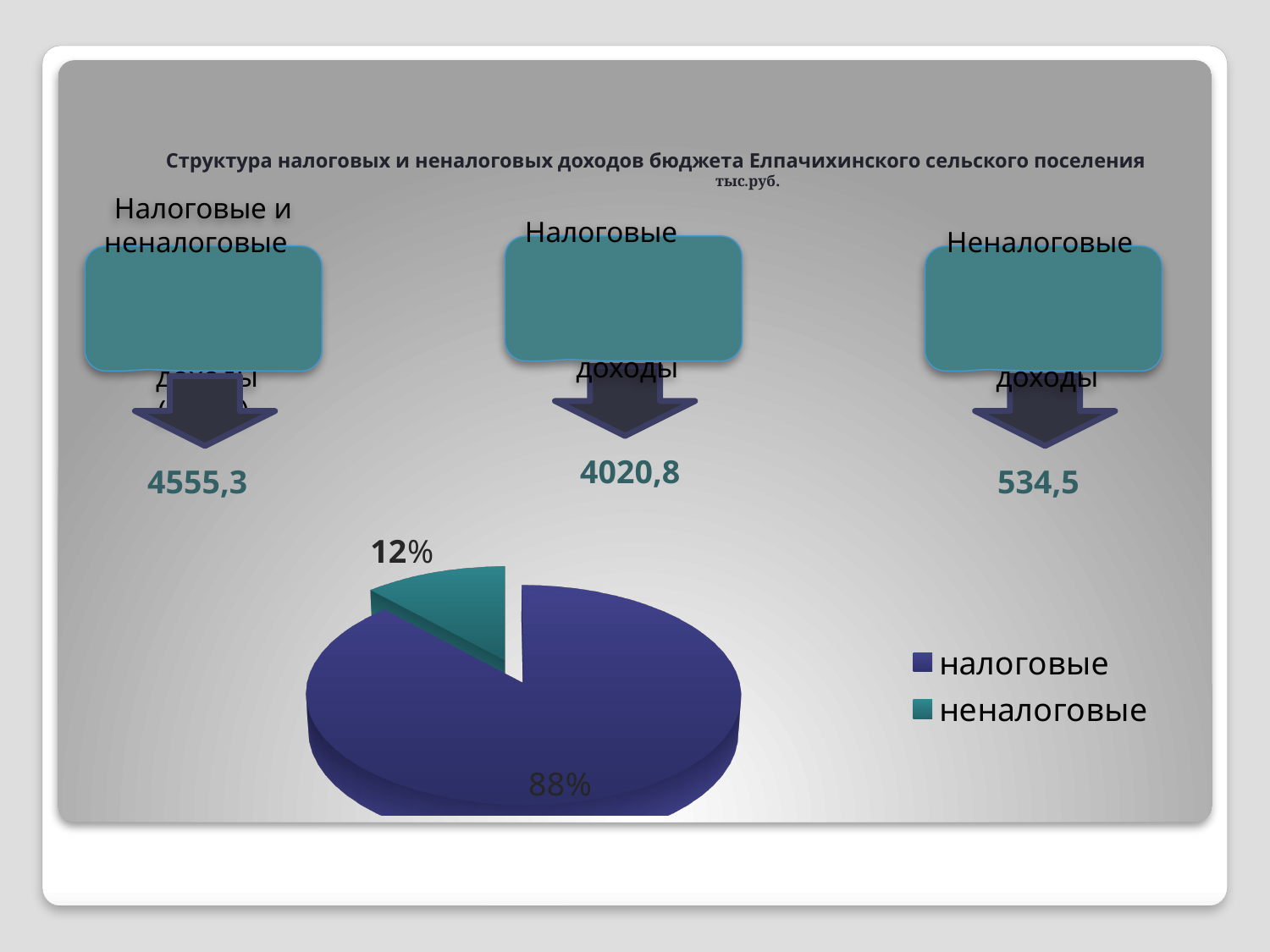
How many slices does the pie chart have? 2 Which slice of the pie chart is the smallest? неналоговые By how many percentage points does the "налоговые" share exceed the "неналоговые" share? 76 How many entries does the legend of the pie chart list? 2 What share of the pie does the "налоговые" slice represent? 88% What kind of chart is shown on the slide? pie chart What colour is the "налоговые" slice in the pie chart? dark blue What colour is the "неналоговые" slice in the pie chart? teal Which slice of the pie chart is the largest? налоговые Which is larger in the pie chart, "налоговые" or "неналоговые"? налоговые What share of the pie does the "неналоговые" slice represent? 12%